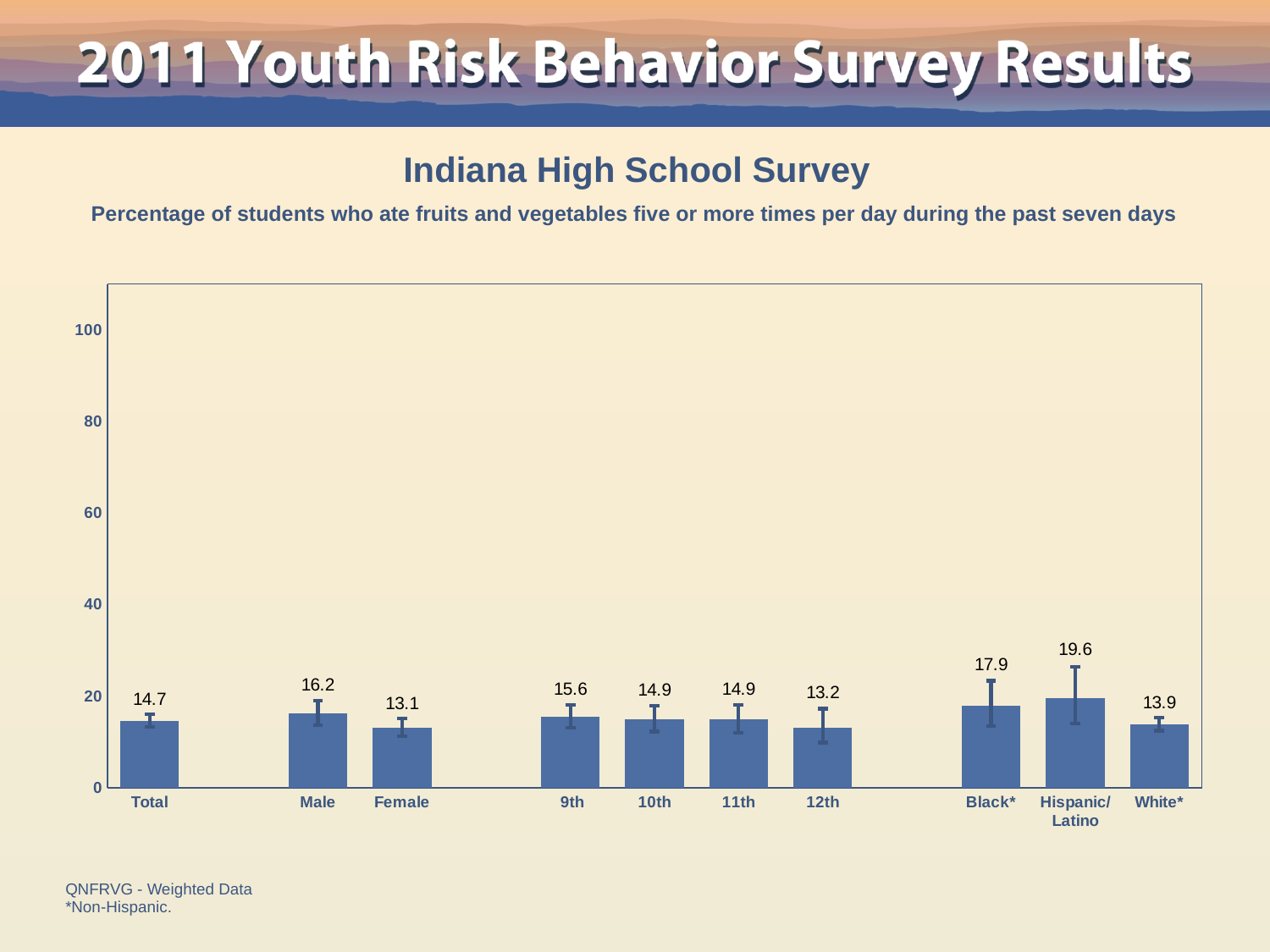
What is the title of the chart? Indiana High School Survey Is the value for 9th grade greater or less than 20? less What is the value for Total? 14.7 Do the values rise or fall from 9th grade to 12th grade? fall Which category has the highest value? Hispanic/Latino What is the difference between the Male and Female values? 3.1 What is the value for 12th grade students? 13.2 Which is larger, the value for Black* or the value for White*? Black* What kind of chart is this? bar chart How many categories are shown on the x axis? 10 What is the value for Hispanic/Latino students? 19.6 Which category has the lowest value? Female